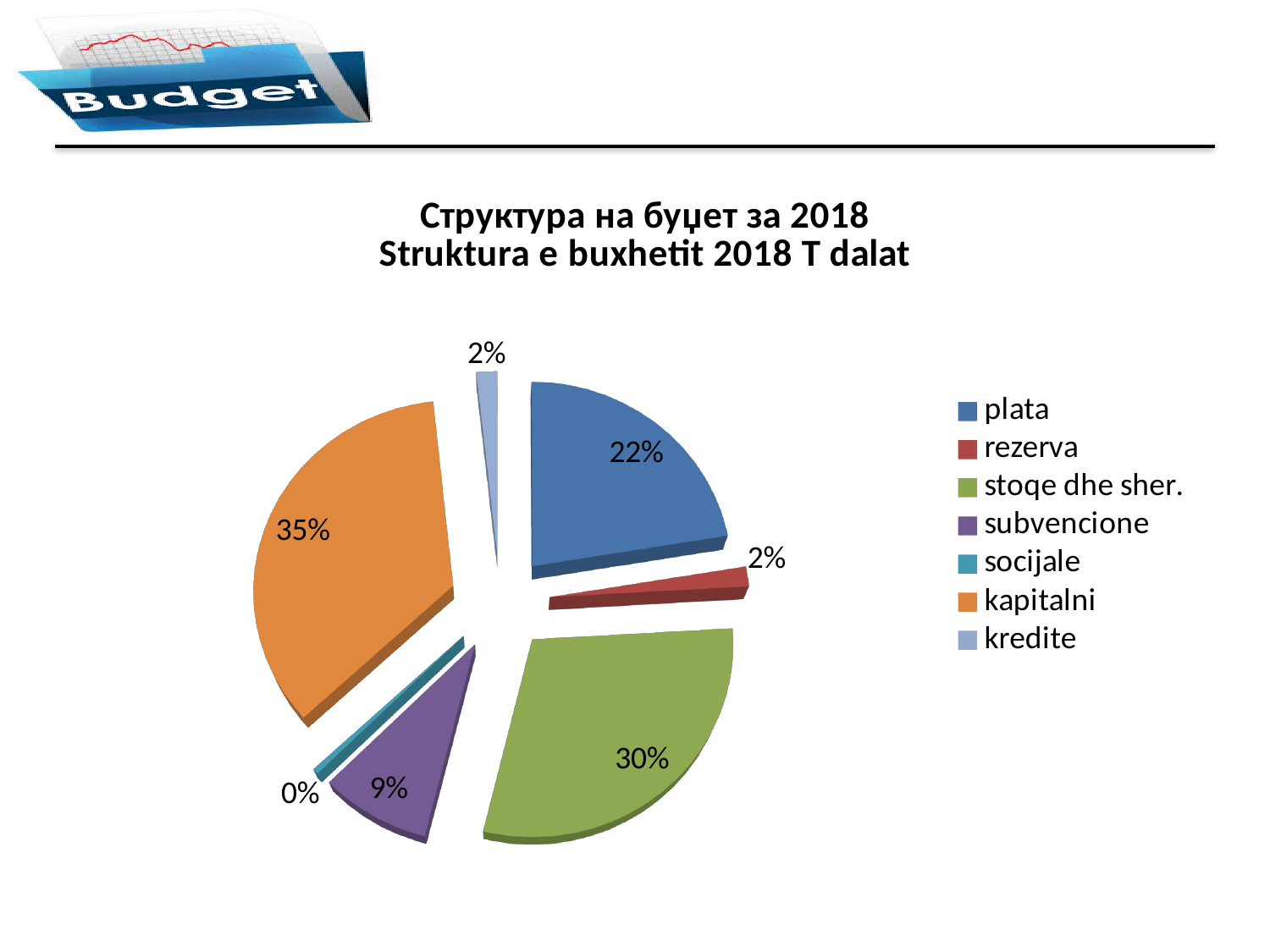
Which is larger, the share for plata or the share for subvencione? plata What is the difference in percentage points between kapitalni and stoqe dhe sher.? 5% How many categories does the legend list? 7 What share of the budget does stoqe dhe sher. represent? 30% What colour is the kapitalni slice? orange Which category has the largest share of the pie? kapitalni What share of the budget does plata represent? 22% What share of the budget does kapitalni represent? 35% What kind of chart is shown on the slide? pie chart Which category has the smallest share of the pie? socijale